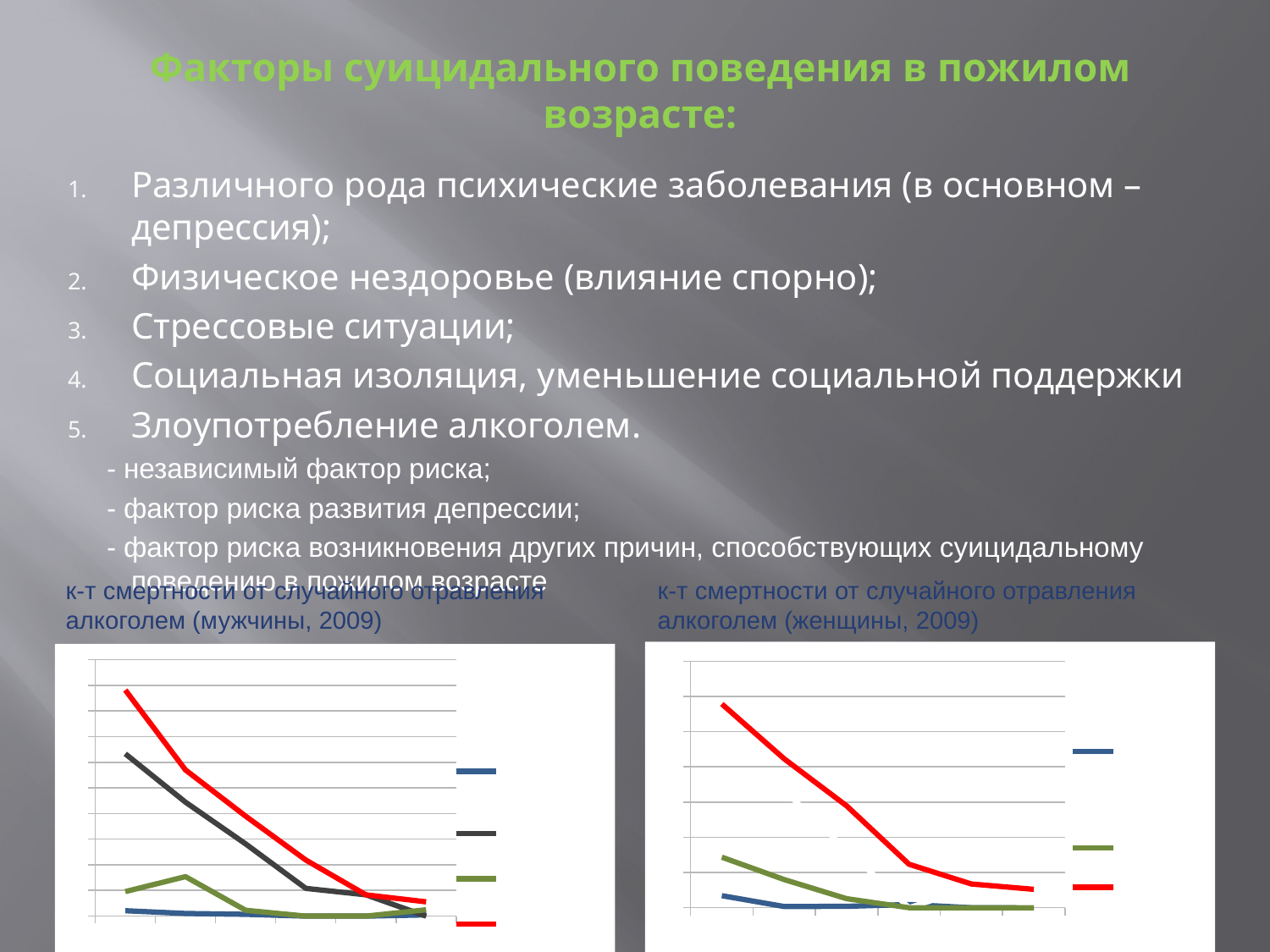
How many series does the legend of the right chart (женщины, 2009) list? 3 What kind of chart is the chart titled 'к-т смертности от случайного отравления алкоголем (женщины, 2009)'? line chart In the left chart (мужчины, 2009), which coloured line has the highest value at the left end of the x axis? the red line What year is given in the titles of both charts on the slide? 2009 Which chart on the slide is about women (женщины)? the right chart What kind of chart is the chart titled 'к-т смертности от случайного отравления алкоголем (мужчины, 2009)'? line chart In the right chart (женщины, 2009), which is larger at the left end of the x axis: the green line or the blue line? the green line In the right chart (женщины, 2009), does the red line rise or fall along the x axis? fall How many series does the legend of the left chart (мужчины, 2009) list? 4 In the right chart (женщины, 2009), which coloured line has the highest value at the left end of the x axis? the red line In the left chart (мужчины, 2009), which is larger at the left end of the x axis: the red line or the blue line? the red line In the left chart (мужчины, 2009), does the red line rise or fall along the x axis? fall